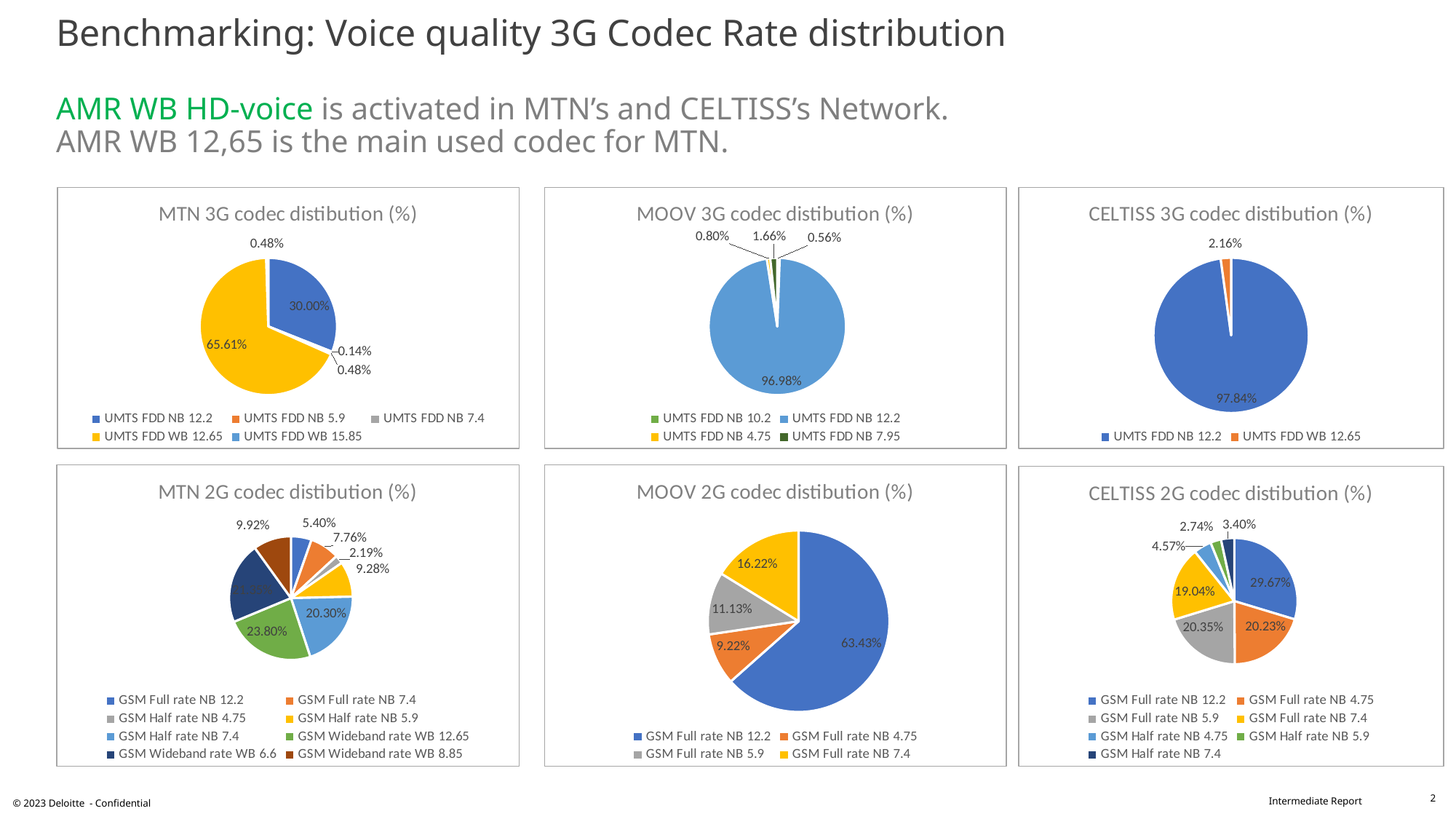
In the MTN 3G codec distribution chart, what share does UMTS FDD NB 12.2 have? 30.00% How many entries does the legend of the CELTISS 2G codec distribution chart list? 7 In the CELTISS 3G codec distribution chart, what share does UMTS FDD WB 12.65 have? 2.16% In the CELTISS 2G codec distribution chart, what share does GSM Full rate NB 12.2 have? 29.67% In the MTN 2G codec distribution chart, which codec has the largest share? GSM Wideband rate WB 12.65 In the MTN 2G codec distribution chart, what share does GSM Half rate NB 7.4 have? 20.30% In the CELTISS 3G codec distribution chart, what is the difference between the UMTS FDD NB 12.2 share and the UMTS FDD WB 12.65 share? 95.68% In the MTN 3G codec distribution chart, what share does UMTS FDD WB 12.65 have? 65.61% What type of chart is the MOOV 3G codec distribution chart? Pie chart In the MOOV 2G codec distribution chart, which is larger: GSM Full rate NB 7.4 or GSM Full rate NB 5.9? GSM Full rate NB 7.4 In the MOOV 3G codec distribution chart, what is the share of the largest slice? 96.98% In the MOOV 2G codec distribution chart, what share does GSM Full rate NB 12.2 have? 63.43%